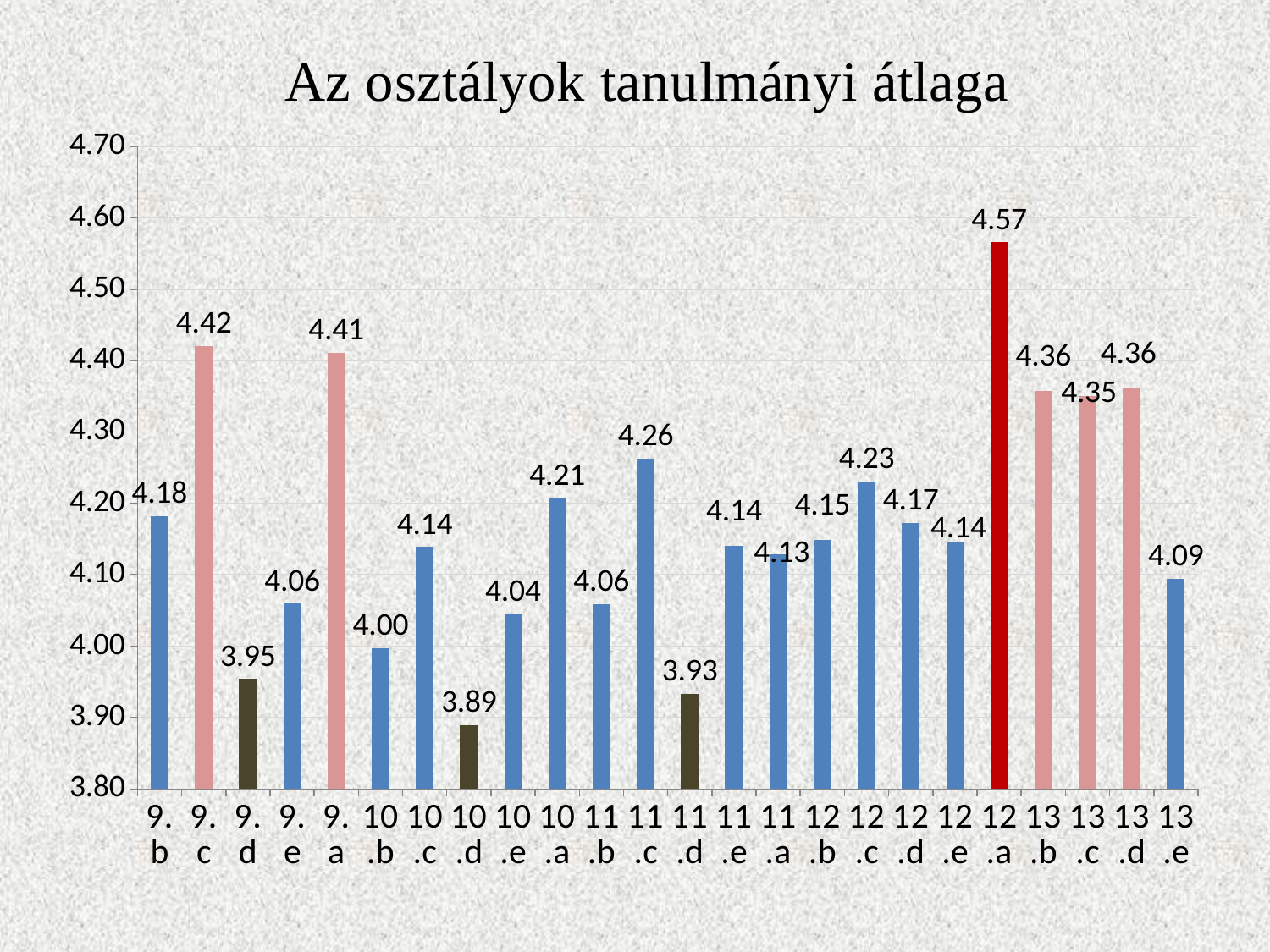
What is the difference between the values for 12.a and 10.d? 0.68 What is the title of the chart? Az osztályok tanulmányi átlaga What kind of chart is this? bar chart What is the value for class 9.c? 4.42 How many classes are shown on the chart? 24 Which class has the lowest average? 10.d What is the value for class 10.d? 3.89 What is the value for class 13.e? 4.09 Which class has the highest average? 12.a Which is larger, the value for 11.c or the value for 12.c? 11.c What is the value for class 12.a? 4.57 What is the difference between the values for 9.c and 9.b? 0.24